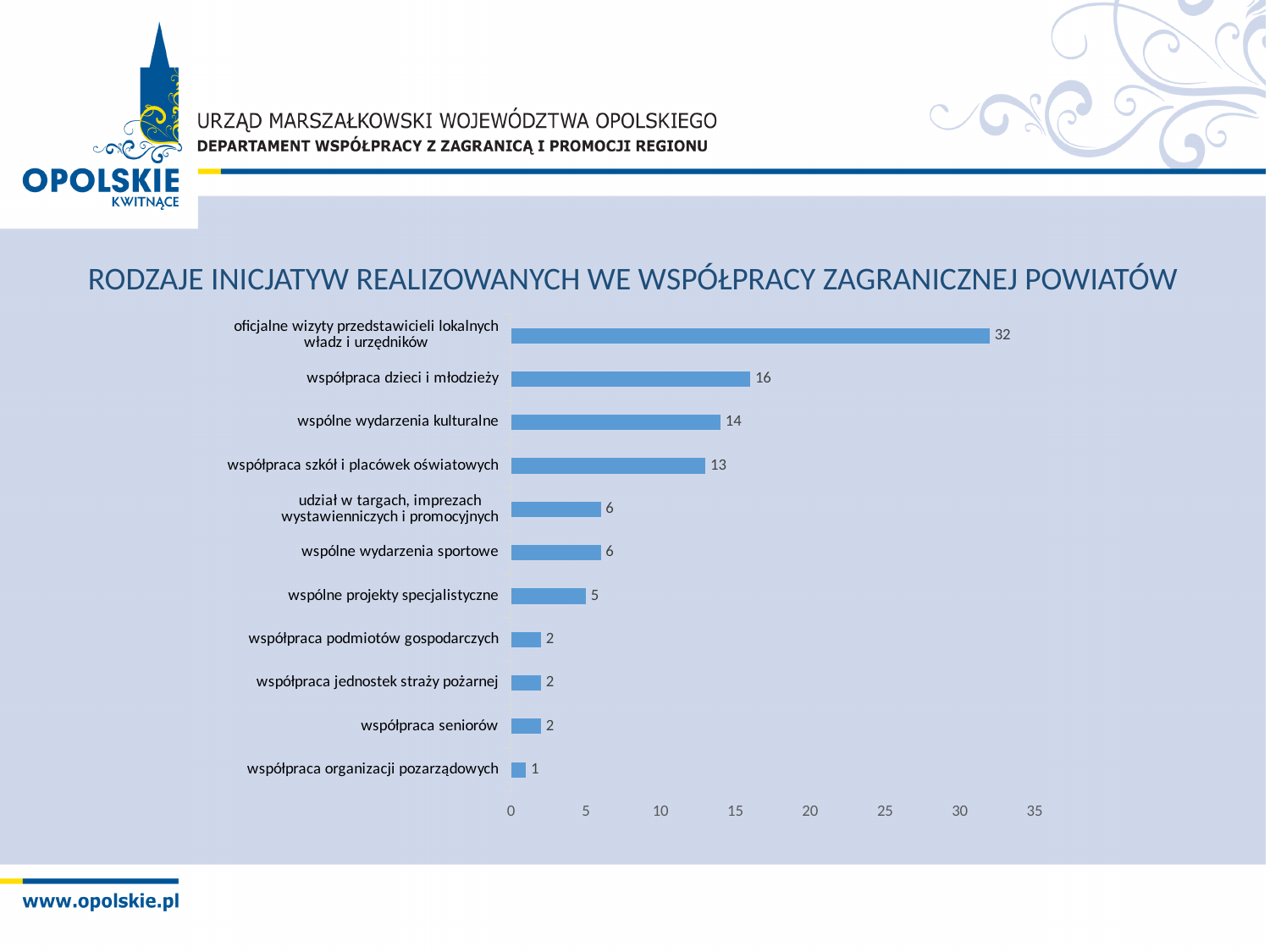
What is the value for "wspólne wydarzenia kulturalne"? 14 What is the value for "wspólne projekty specjalistyczne"? 5 What is the title of the chart? RODZAJE INICJATYW REALIZOWANYCH WE WSPÓŁPRACY ZAGRANICZNEJ POWIATÓW What is the value for "współpraca dzieci i młodzieży"? 16 What kind of chart is shown on the slide? bar chart How many categories are shown in the chart? 11 Which category has the highest value? oficjalne wizyty przedstawicieli lokalnych władz i urzędników What is the difference between the values for "oficjalne wizyty przedstawicieli lokalnych władz i urzędników" and "współpraca dzieci i młodzieży"? 16 What is the value for "współpraca szkół i placówek oświatowych"? 13 Which category has the lowest value? współpraca organizacji pozarządowych Which is larger: the value for "wspólne wydarzenia kulturalne" or for "wspólne wydarzenia sportowe"? wspólne wydarzenia kulturalne Is the value for "oficjalne wizyty przedstawicieli lokalnych władz i urzędników" greater or less than 30? greater